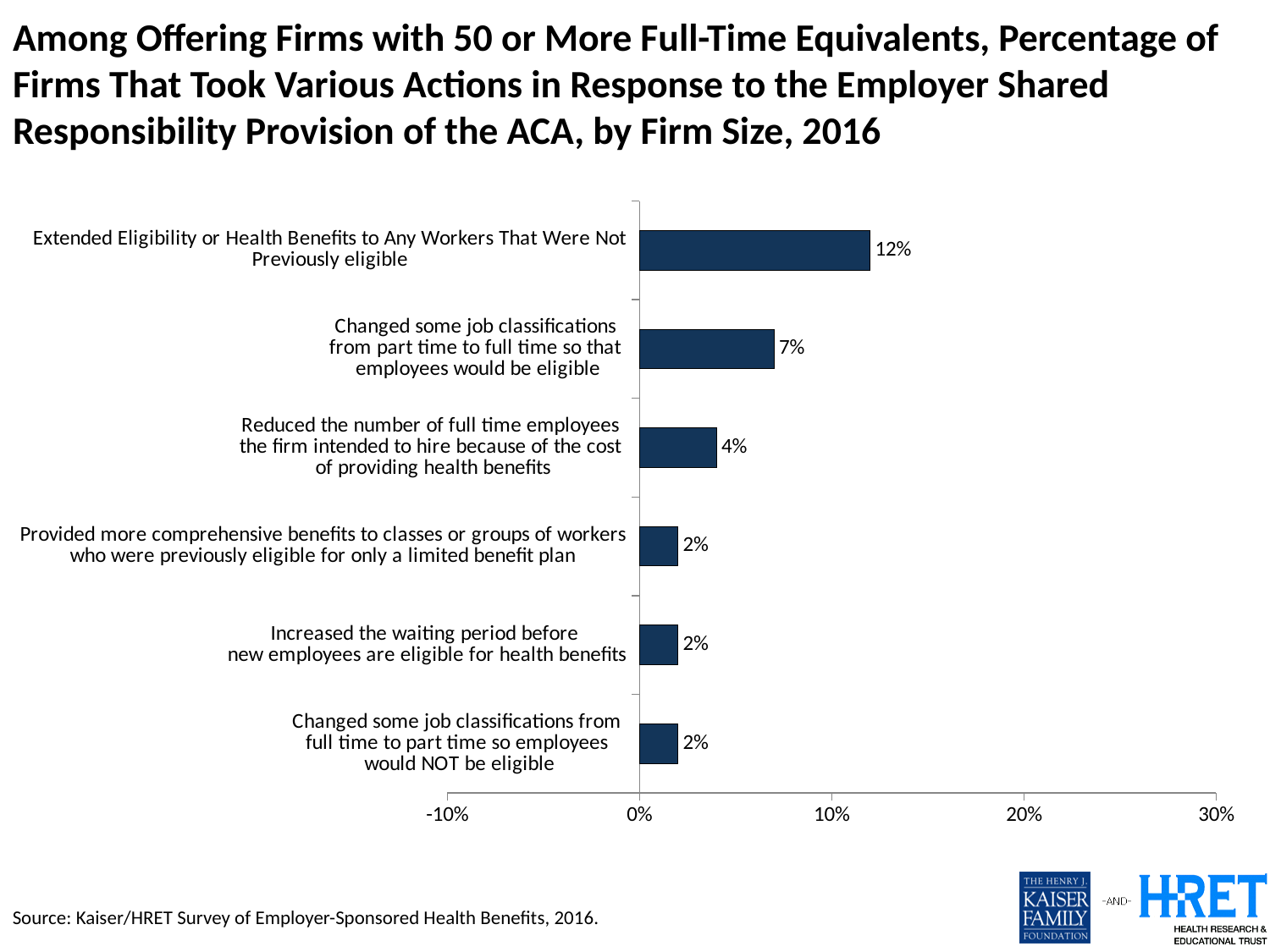
What percentage of firms reduced the number of full time employees the firm intended to hire because of the cost of providing health benefits? 4% What percentage of firms changed some job classifications from part time to full time so that employees would be eligible? 7% Which is larger: the percentage of firms that reduced the number of full time employees they intended to hire, or the percentage that changed job classifications from full time to part time? Reduced the number of full time employees the firm intended to hire What is the difference between the percentage of firms that changed job classifications from part time to full time and the percentage that reduced the number of full time employees they intended to hire? 3 percentage points Which action has the highest percentage of firms? Extended Eligibility or Health Benefits to Any Workers That Were Not Previously eligible Is the value for firms that extended eligibility to previously ineligible workers greater or less than 10%? greater What is the source cited for the chart? Kaiser/HRET Survey of Employer-Sponsored Health Benefits, 2016 What percentage of firms increased the waiting period before new employees are eligible for health benefits? 2% What percentage of firms extended eligibility or health benefits to any workers that were not previously eligible? 12% What is the difference in percentage points between firms that extended eligibility to previously ineligible workers and firms that changed job classifications from part time to full time? 5 percentage points What type of chart is shown on the slide? Bar chart How many actions (categories) are shown in the chart? 6